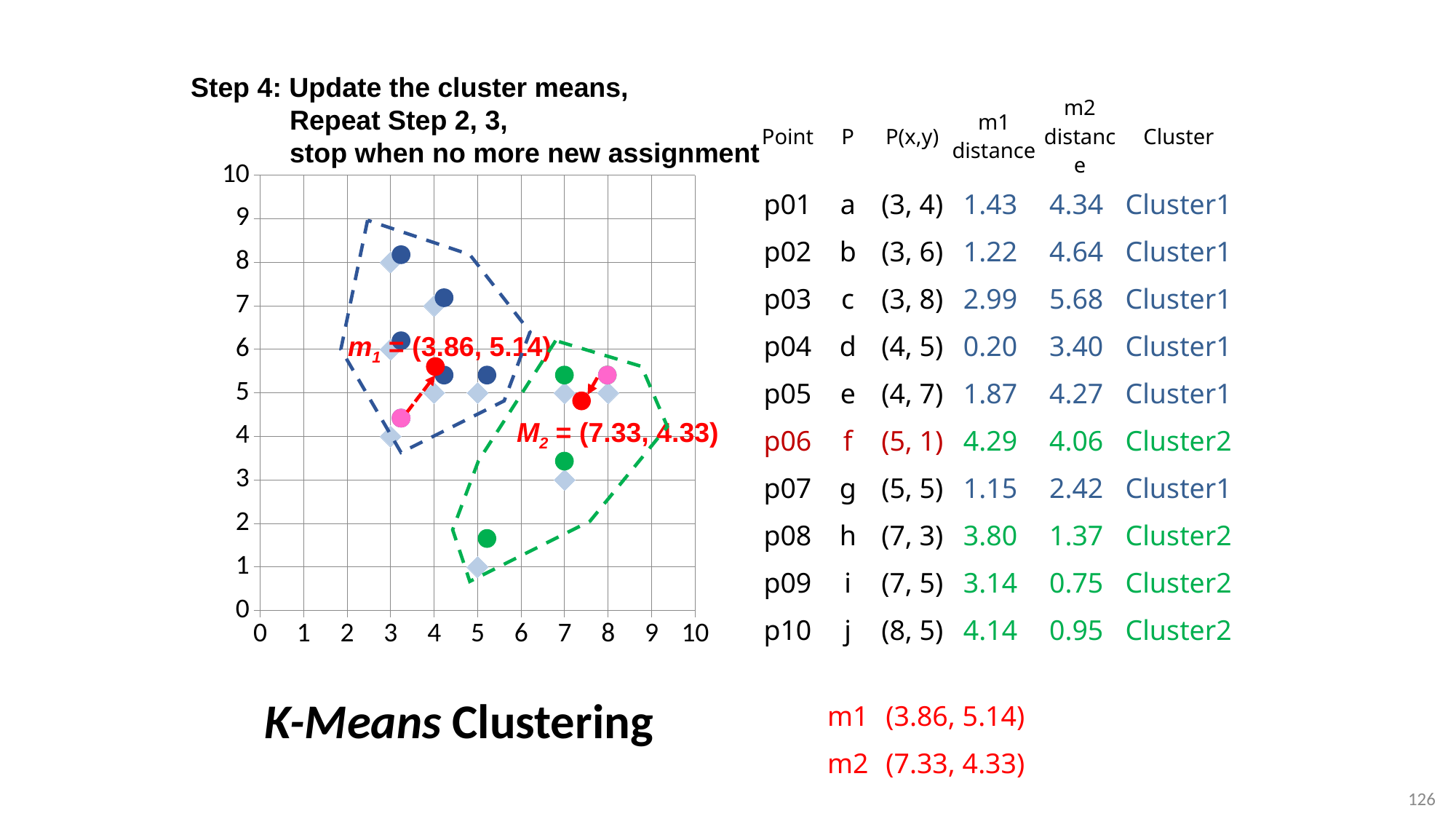
What are the coordinates of the cluster mean m1 shown on the chart? (3.86, 5.14) Which cluster mean has the larger x-coordinate, m1 or M2? M2 How many clusters are outlined with dashed lines on the chart? 2 Is the y-coordinate of the cluster mean M2 greater or less than 5? less Is the x-coordinate of the cluster mean m1 greater or less than 4? less What kind of chart is shown on the slide? scatter chart Which point has the lowest y-coordinate on the chart? f (5, 1) What are the coordinates of the cluster mean M2 shown on the chart? (7.33, 4.33) How many data points (light-blue diamond markers) are plotted on the chart? 10 What is the difference between the x-coordinates of M2 and m1? 3.47 What is the maximum value shown on the y axis of the chart? 10 Which point has the highest y-coordinate on the chart? c (3, 8)